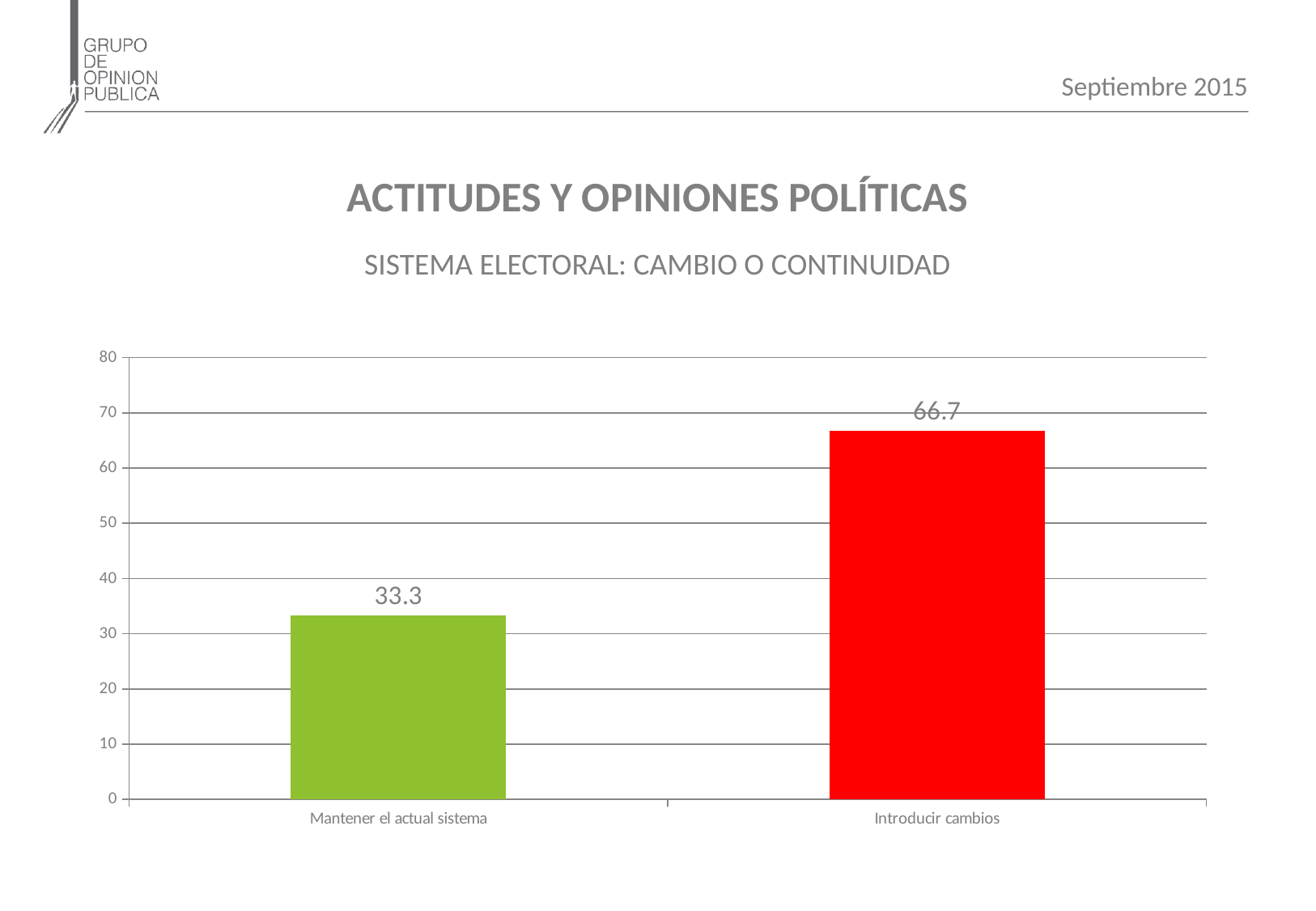
What is the value for "Introducir cambios"? 66.7 What is the total of the two values shown in the chart? 100 Is the value for "Introducir cambios" greater or less than 60? greater What kind of chart is shown on the slide? bar chart What is the difference between the values for "Introducir cambios" and "Mantener el actual sistema"? 33.4 Which category has the lowest value? Mantener el actual sistema How many categories are shown in the chart? 2 What colour is the bar for "Introducir cambios"? red What is the value for "Mantener el actual sistema"? 33.3 Which is larger, the value for "Mantener el actual sistema" or the value for "Introducir cambios"? Introducir cambios Which category has the highest value? Introducir cambios Is the value for "Mantener el actual sistema" greater or less than 40? less